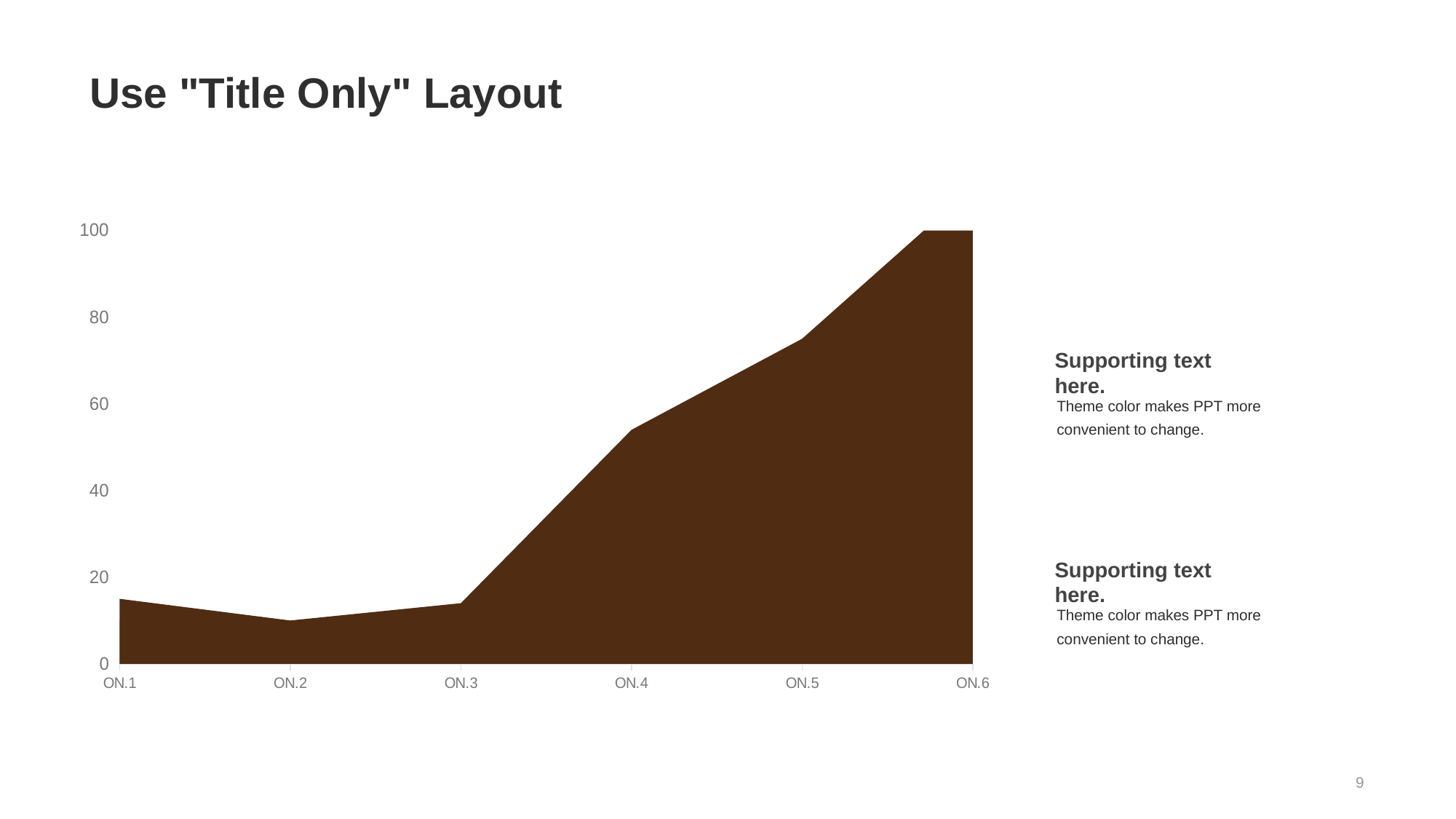
Is the value for ON.5 greater or less than 60? greater Which category has the lowest value? ON.2 Is the value for ON.1 greater or less than 20? less What is the highest value shown on the y axis? 100 Which category has the highest value? ON.6 How many categories are shown on the x axis of the chart? 6 Do the values generally rise or fall from ON.3 to ON.6? rise What kind of chart is shown on the slide? area chart Is the value for ON.2 greater or less than 20? less Which is larger, the value for ON.4 or the value for ON.3? ON.4